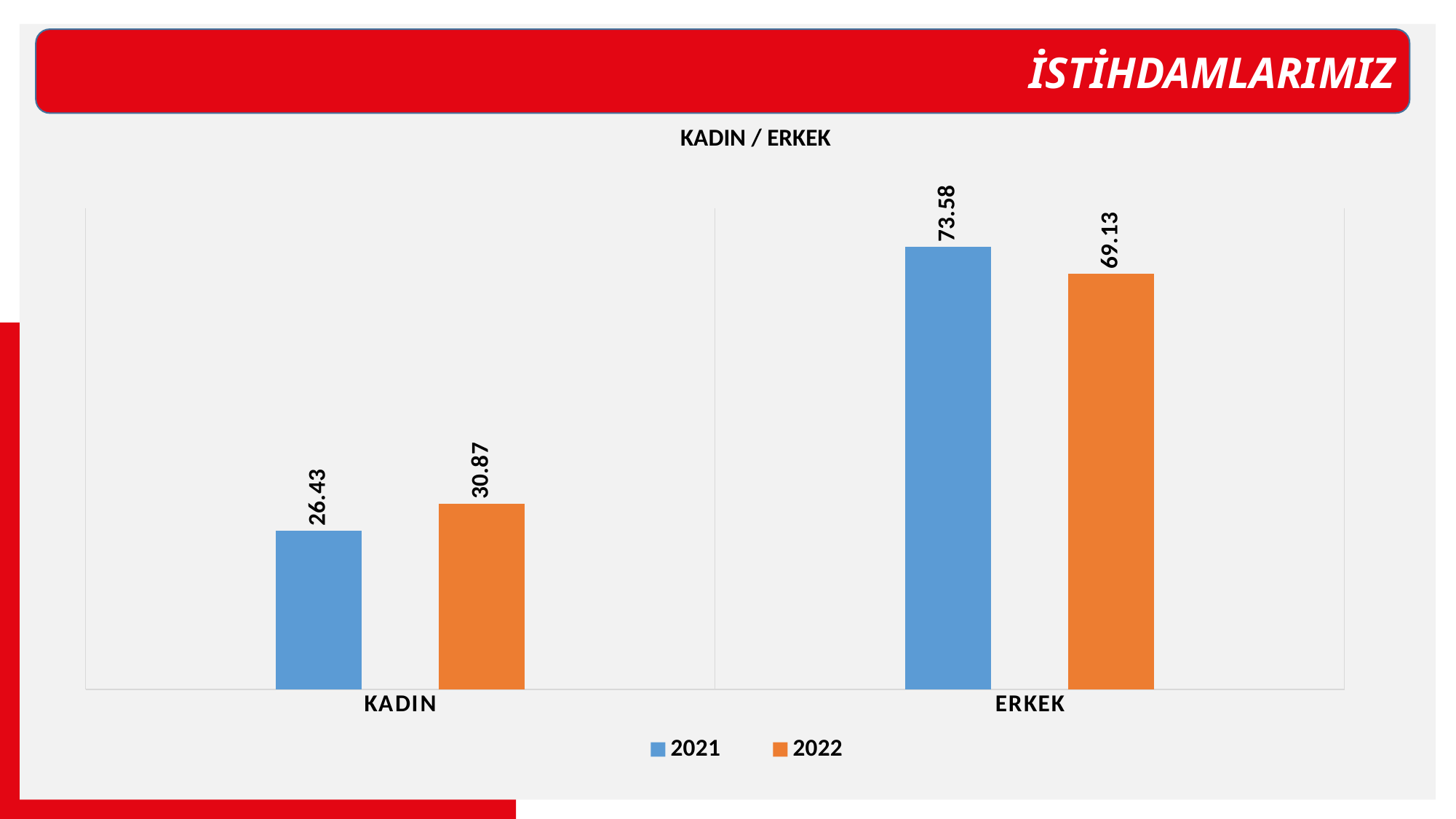
What is the difference between the ERKEK values for 2021 and 2022? 4.45 How many categories are shown on the x axis? 2 How many series does the legend list? 2 What is the value for KADIN in 2021? 26.43 Which is larger, the KADIN value for 2021 or the KADIN value for 2022? 2022 What is the value for KADIN in 2022? 30.87 What is the value for ERKEK in 2021? 73.58 Which category has the lowest value in 2022? KADIN Which category has the highest value in 2021? ERKEK What is the difference between the KADIN values for 2022 and 2021? 4.44 What kind of chart is shown on the slide? Bar chart What is the value for ERKEK in 2022? 69.13